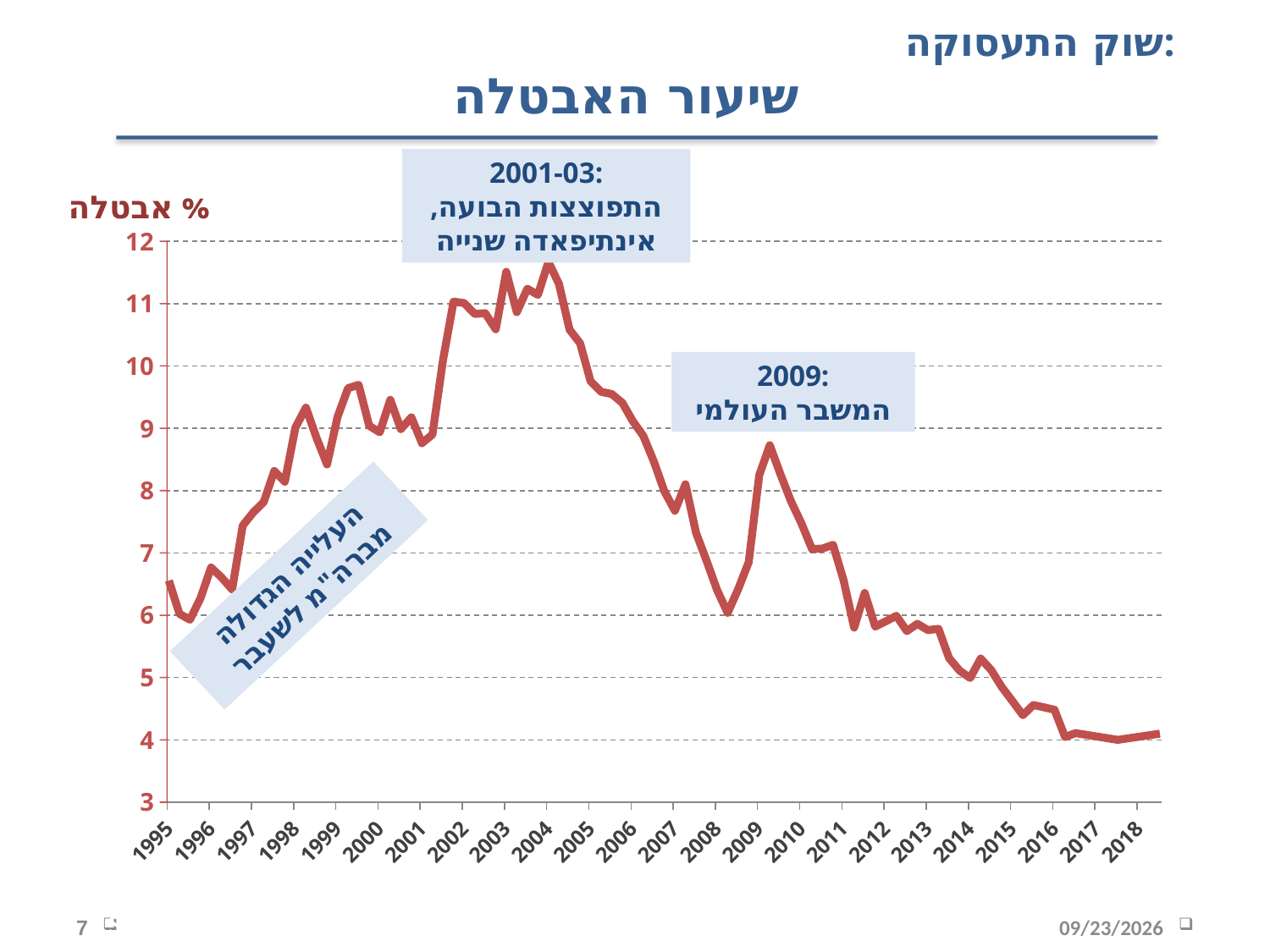
Is the value at the start of the series in 1995 greater or less than 7? less Is the local peak around 2009 greater or less than 8? greater Is the value around 2000 greater or less than 8? greater What is the title of the chart? שיעור האבטלה How many year labels are shown on the horizontal axis? 24 What kind of chart is shown on the slide? line chart Does the unemployment rate generally rise or fall between 2004 and 2018? fall Does the unemployment rate generally rise or fall between 1995 and 2002? rise What label is shown on the vertical axis of the chart? % אבטלה